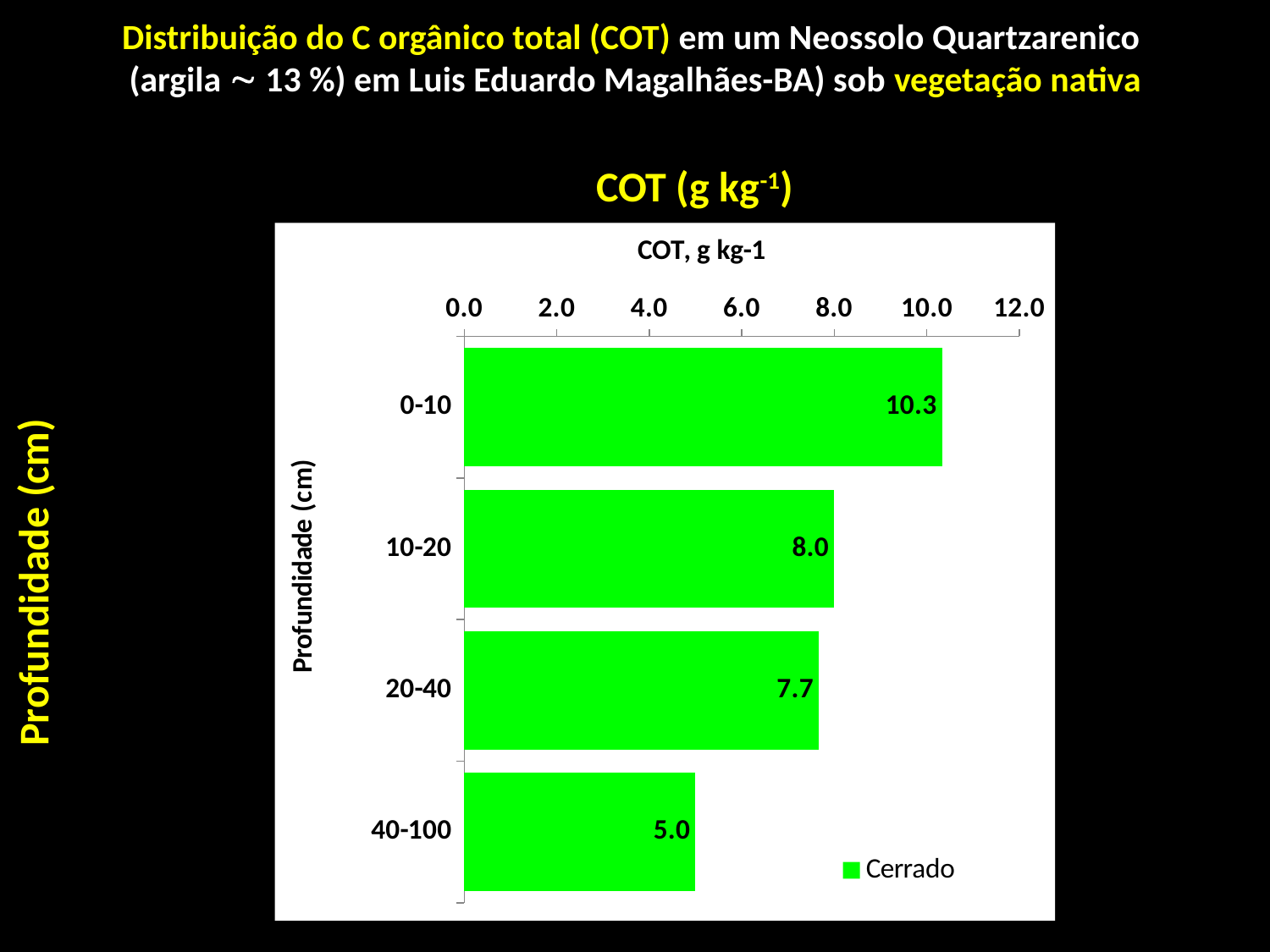
What is the COT value for the 20-40 cm depth? 7.7 What kind of chart is shown on the slide? Bar chart Which depth has the lowest COT value? 40-100 Which depth has the highest COT value? 0-10 What is the difference between the COT values for the 0-10 and 40-100 cm depths? 5.3 What is the COT value for the 40-100 cm depth? 5.0 What is the COT value for the 0-10 cm depth? 10.3 Which has a larger COT value, the 10-20 cm depth or the 20-40 cm depth? 10-20 How many series does the legend list? 1 What is the name of the series shown in the legend? Cerrado How many depth categories are shown in the chart? 4 What is the COT value for the 10-20 cm depth? 8.0